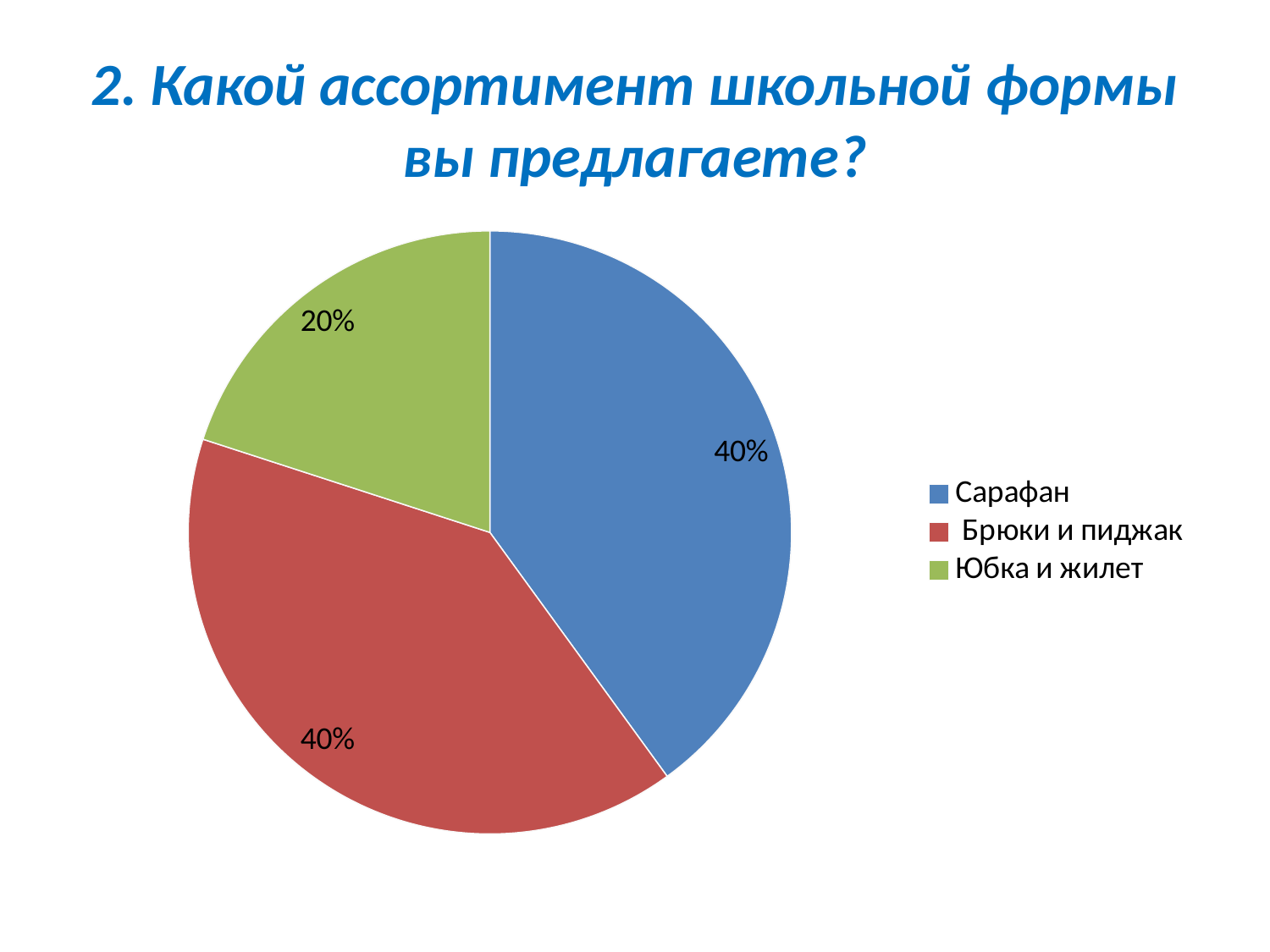
What kind of chart is shown on the slide? Pie chart Which is larger, the share for Брюки и пиджак or the share for Юбка и жилет? Брюки и пиджак Which category has the smallest slice of the pie? Юбка и жилет What share of the pie does Сарафан have? 40% What is the title of the slide? 2. Какой ассортимент школьной формы вы предлагаете? What share of the pie does Юбка и жилет have? 20% What is the difference between the shares of Сарафан and Юбка и жилет? 20% How many slices does the pie chart have? 3 What share of the pie does Брюки и пиджак have? 40% What colour is the slice for Юбка и жилет? Green Do Сарафан and Брюки и пиджак have the same share of the pie? Yes How many entries does the legend list? 3